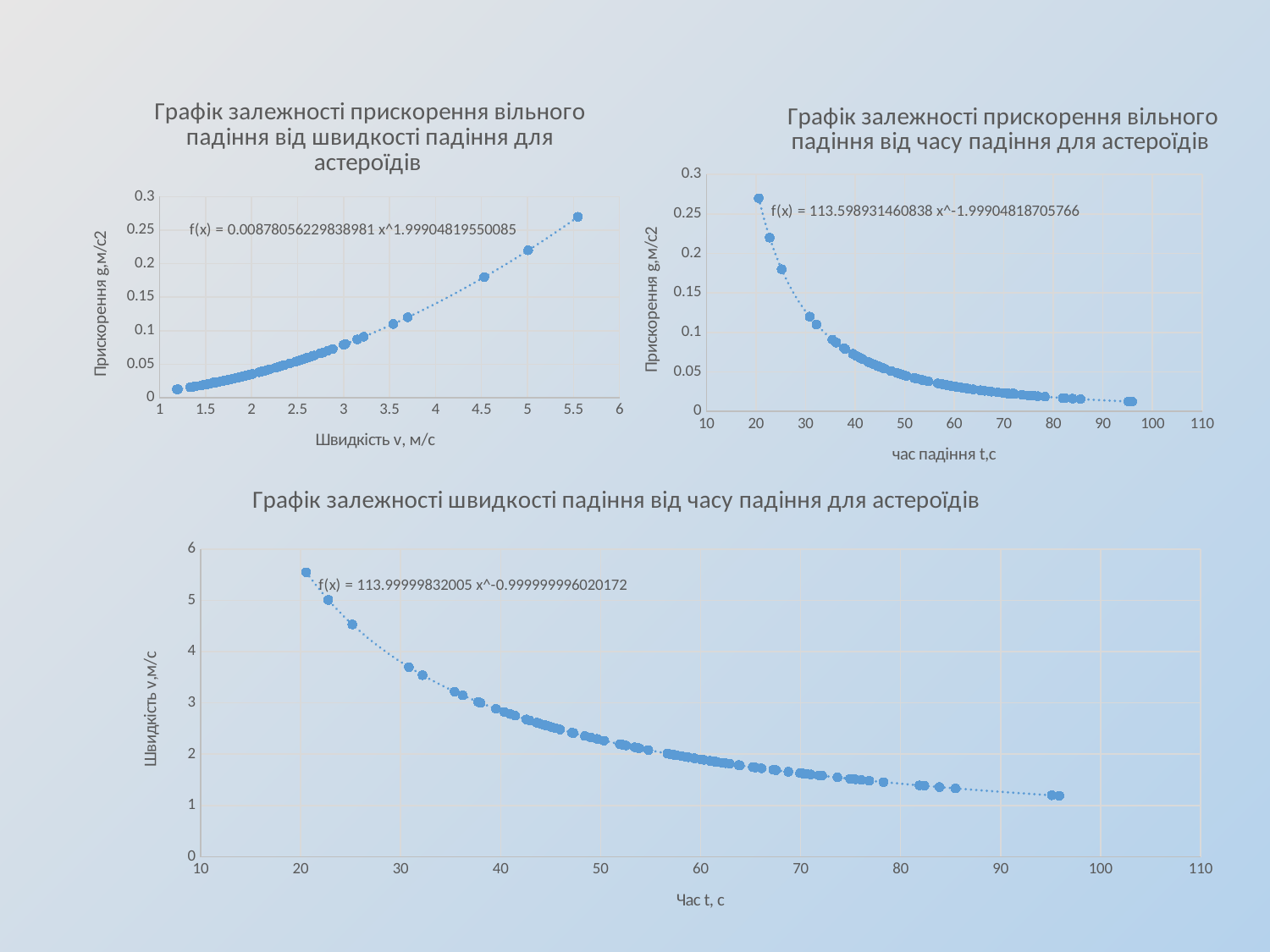
In the top-left chart, is the acceleration value at the highest speed point (about 5.5 м/с) greater or less than 0.2? greater In the bottom chart, is the speed value at the first point (about 20 с) greater or less than 5? greater In the bottom chart, is the speed value at about 30 с greater or less than 3? greater What is the x-axis label of the top-left chart? Швидкість v, м/с In the top-left chart (acceleration vs. speed), do the values rise or fall as speed increases along the x axis? rise In the bottom chart (speed vs. time), do the values rise or fall as time increases along the x axis? fall What is the trendline equation shown on the bottom chart? f(x) = 113.99999832005 x^-0.999999996020172 In the top-right chart (acceleration vs. time), do the values rise or fall as time increases along the x axis? fall What kind of chart is the bottom chart titled 'Графік залежності швидкості падіння від часу падіння для астероїдів'? scatter chart